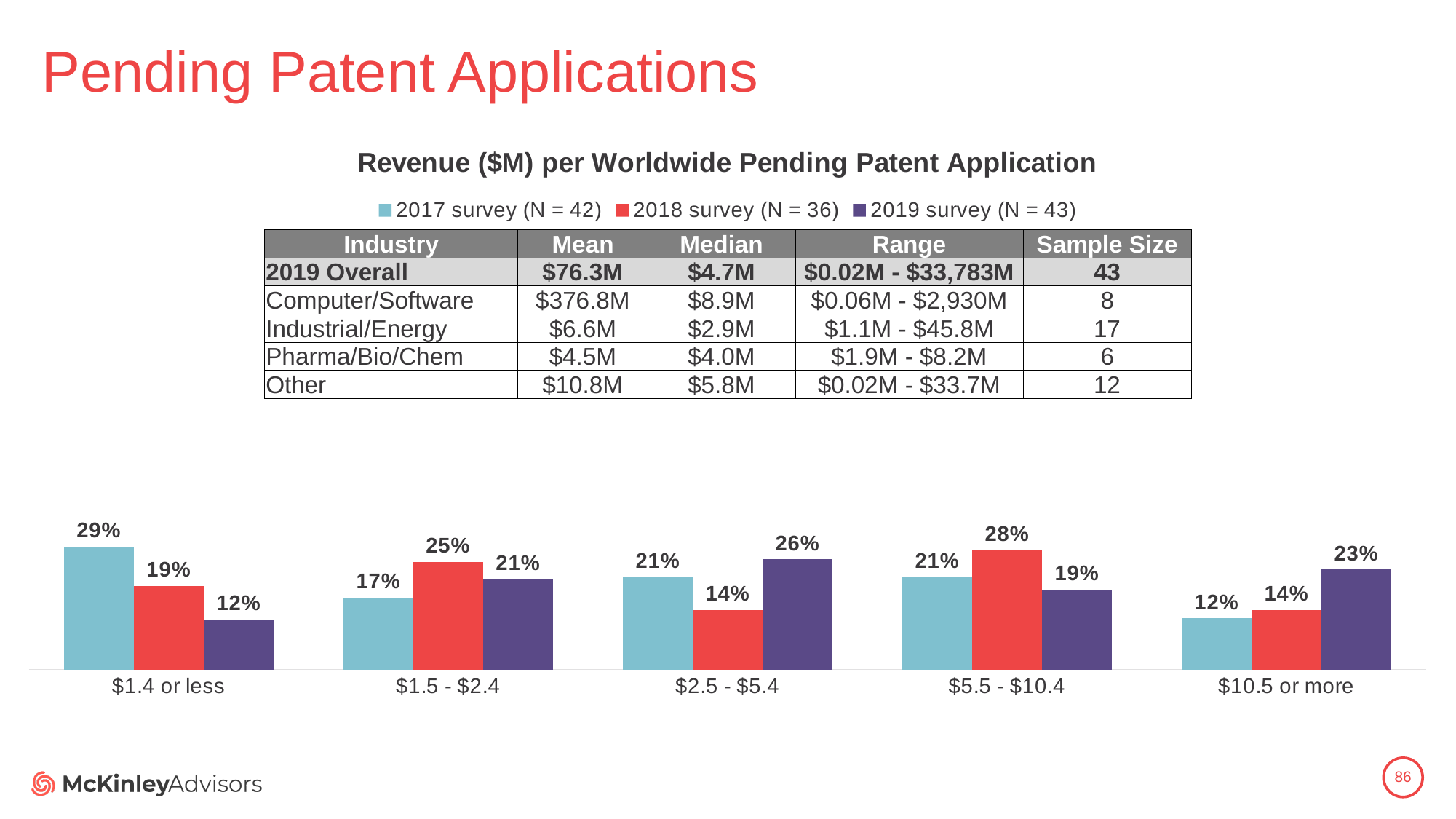
In the "$10.5 or more" category, which survey has the larger value: 2017 or 2019? 2019 survey What is the difference between the 2017 survey and 2019 survey values in the "$1.4 or less" category? 17% What is the title of the chart? Revenue ($M) per Worldwide Pending Patent Application Which category has the lowest value for the 2019 survey? $1.4 or less What is the value for the 2018 survey in the "$5.5 - $10.4" category? 28% What kind of chart is shown on the slide? Bar chart What is the value for the 2019 survey in the "$2.5 - $5.4" category? 26% How many series does the chart legend list? 3 What is the value for the 2017 survey in the "$1.4 or less" category? 29% Which category has the highest value for the 2017 survey? $1.4 or less What is the sample size (N) for the 2018 survey shown in the legend? 36 How many revenue categories are shown on the x axis of the chart? 5